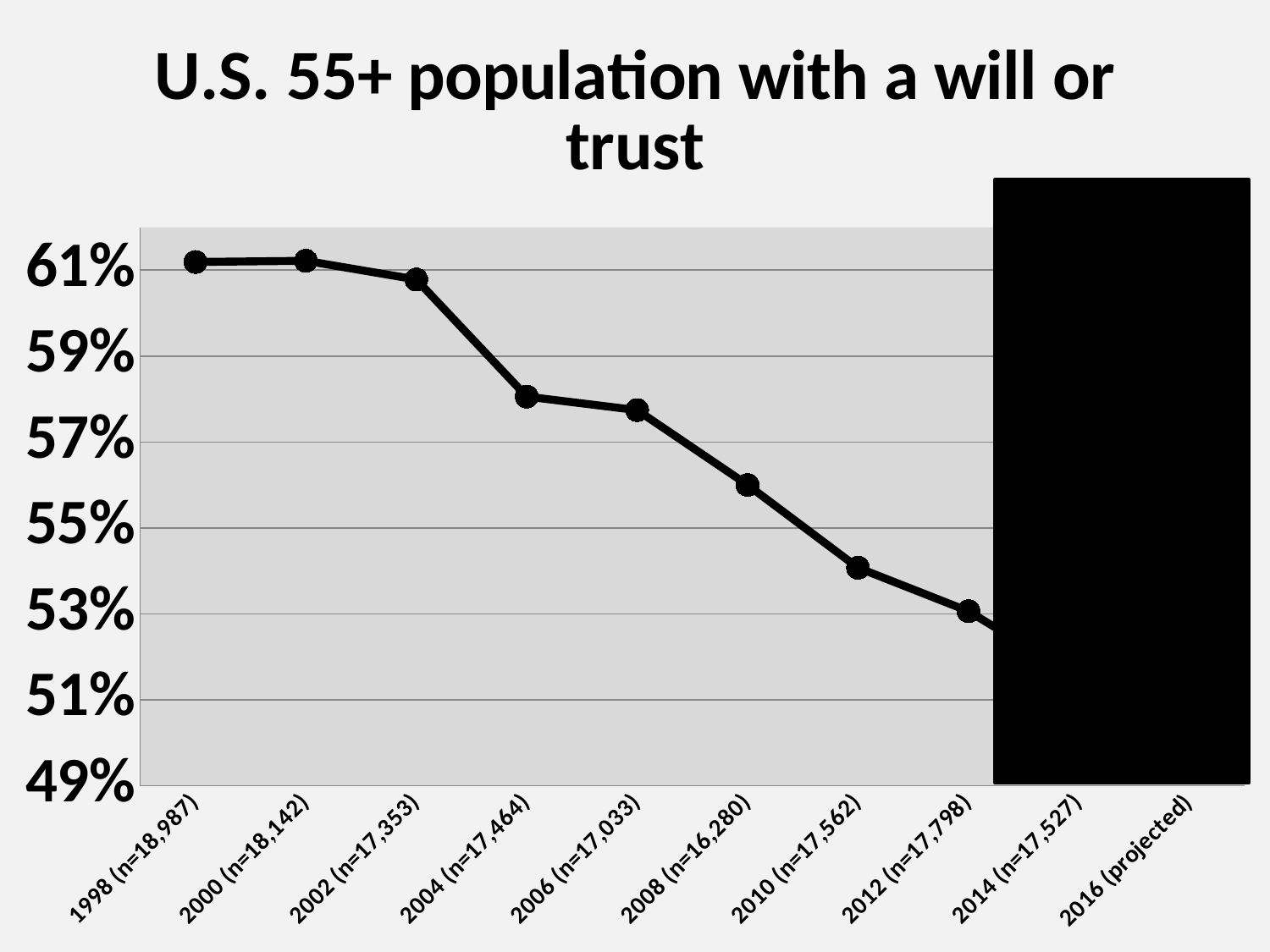
Is the value for 2004 (n=17,464) greater or less than 57%? greater How many category labels are shown on the x axis? 10 Is the value for 2012 (n=17,798) greater or less than 55%? less What kind of chart is shown on the slide? line chart What is the title of the chart? U.S. 55+ population with a will or trust What sample size is given in the x-axis label for 2008? n=16,280 Is the value for 2008 (n=16,280) greater or less than 57%? less Which is larger, the value for 2004 (n=17,464) or the value for 2010 (n=17,562)? 2004 (n=17,464) Which is larger, the value for 2008 (n=16,280) or the value for 2002 (n=17,353)? 2002 (n=17,353) Do the plotted values generally rise or fall from 1998 to 2012? fall